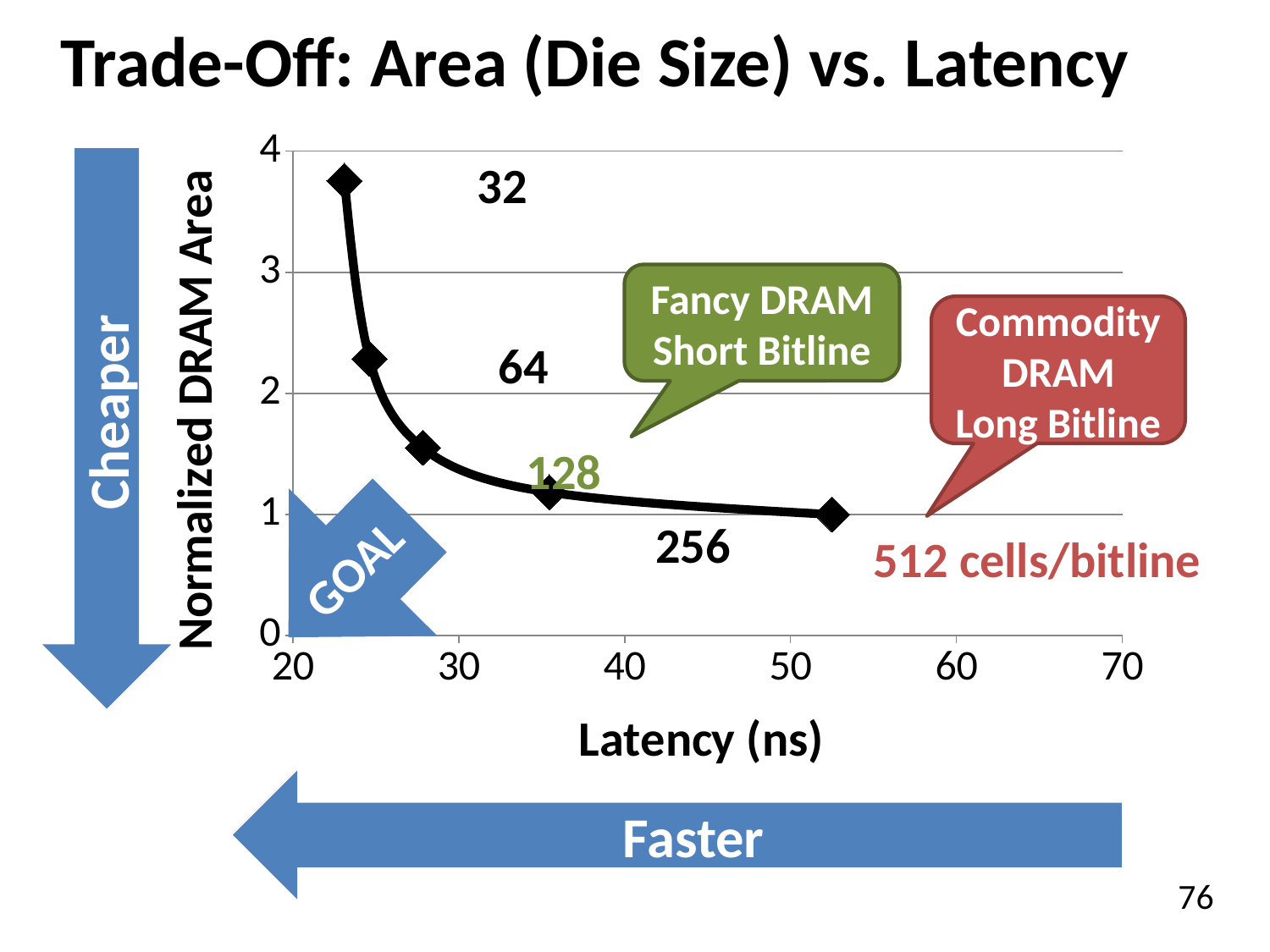
How many data points are plotted on the chart? 5 Is the normalized DRAM area for 64 cells/bitline greater or less than 2? greater Which cells/bitline configuration has the highest normalized DRAM area? 32 As latency increases along the x axis, does the normalized DRAM area rise or fall? fall Which cells/bitline configuration has the highest latency? 512 Is the normalized DRAM area for 32 cells/bitline greater or less than 3? greater What is the label of the y axis? Normalized DRAM Area Which has a larger normalized DRAM area, 128 cells/bitline or 256 cells/bitline? 128 cells/bitline Which cells/bitline configuration has the lowest normalized DRAM area? 512 What is the label of the x axis? Latency (ns) What kind of chart is shown on the slide? line chart Is the latency for 512 cells/bitline greater or less than 50 ns? greater